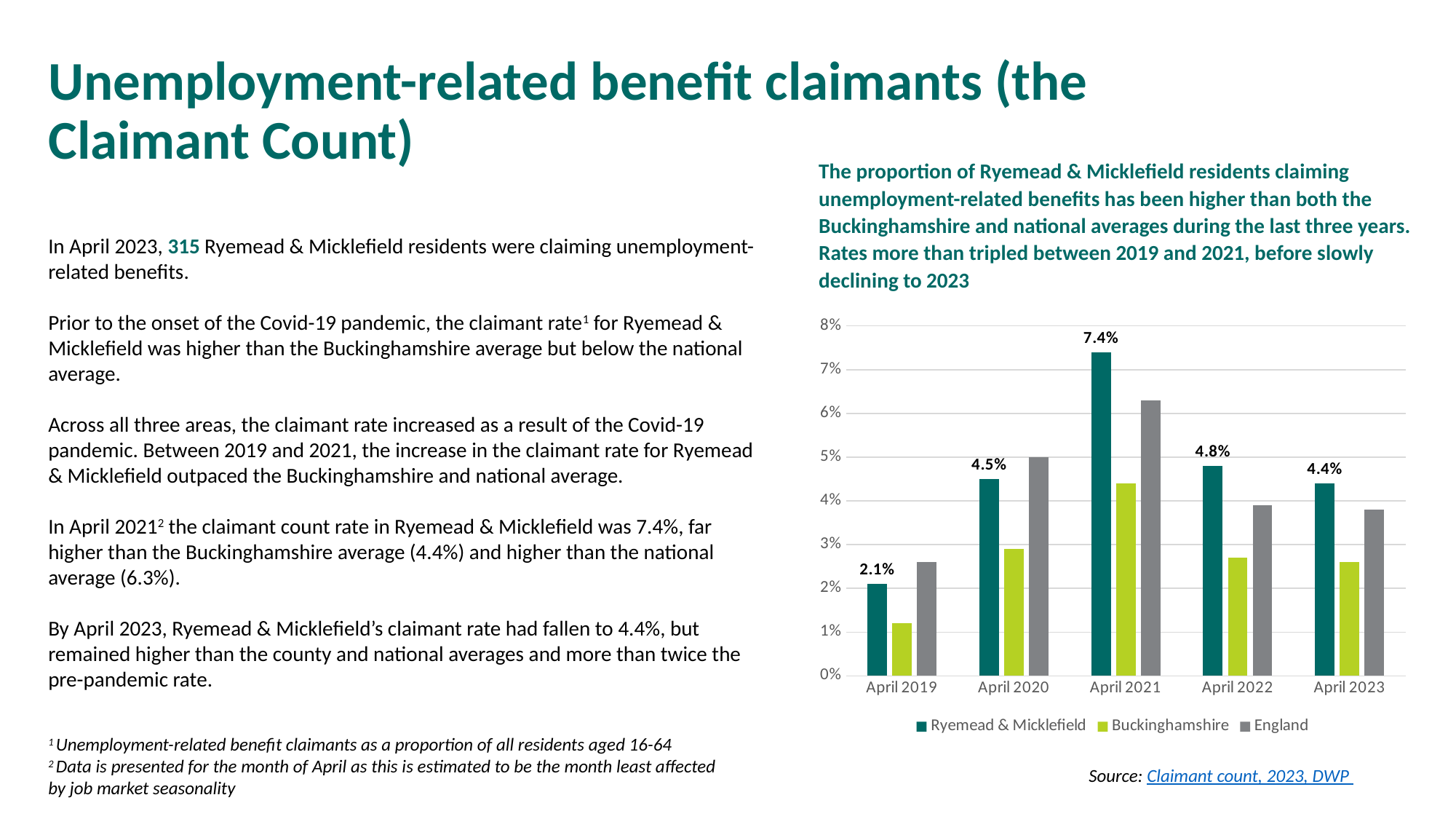
In which April does Ryemead & Micklefield have its highest claimant rate? April 2021 How many series does the legend list? 3 What is the claimant rate for Ryemead & Micklefield in April 2019? 2.1% In April 2021, which is larger: the Ryemead & Micklefield rate or the England rate? Ryemead & Micklefield In April 2019, which is larger: the Ryemead & Micklefield rate or the England rate? England What is the claimant rate for Ryemead & Micklefield in April 2021? 7.4% Is the England value for April 2021 greater or less than 6%? greater Is the Buckinghamshire value for April 2019 greater or less than 2%? less In which April does Ryemead & Micklefield have its lowest claimant rate? April 2019 By how many percentage points did the Ryemead & Micklefield claimant rate rise between April 2019 and April 2021? 5.3 percentage points Does the Ryemead & Micklefield claimant rate rise or fall from April 2021 to April 2023? fall What is the claimant rate for Ryemead & Micklefield in April 2023? 4.4%